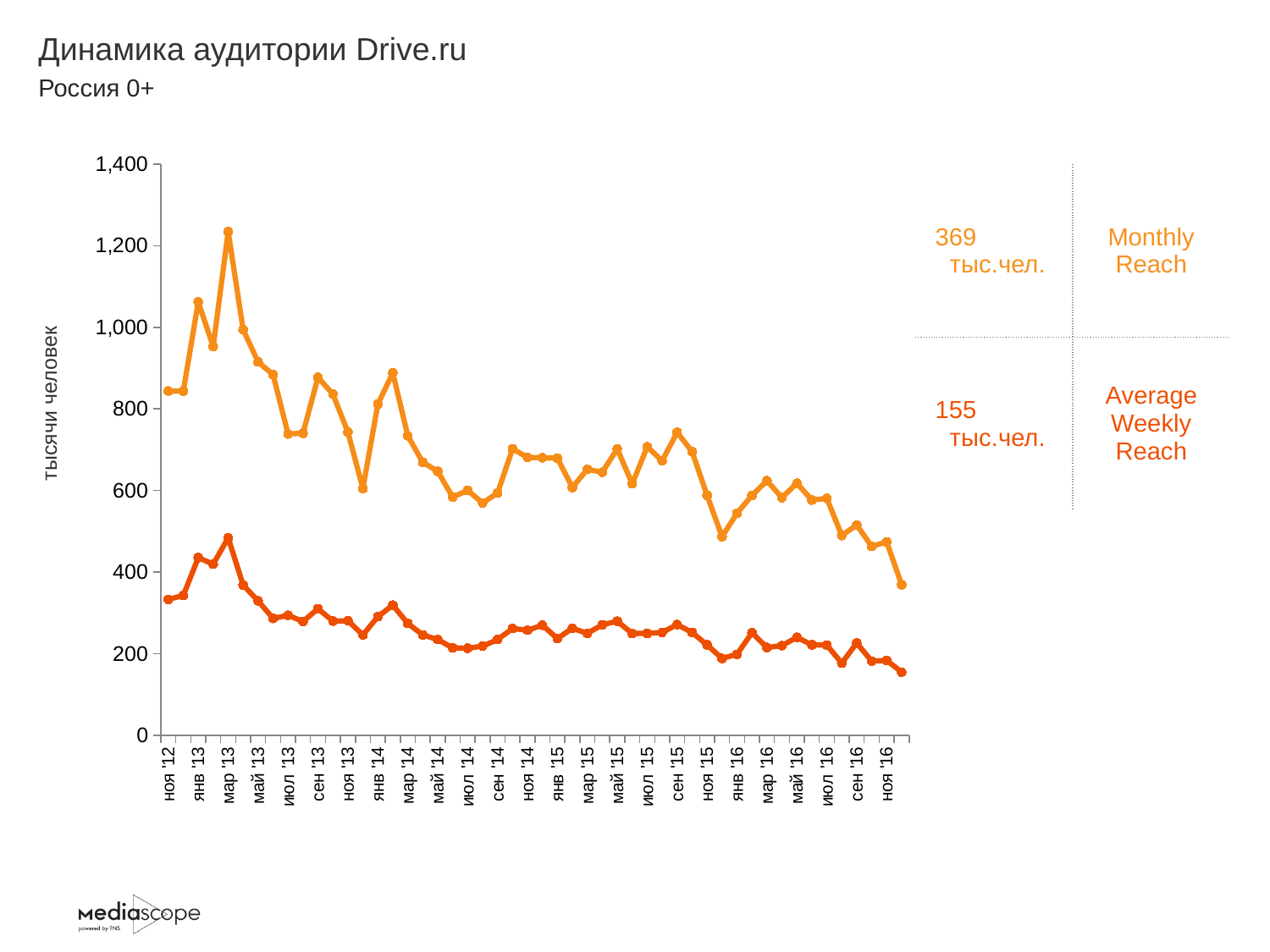
In which month does the Monthly Reach line reach its highest point? мар '13 What is the difference between the printed Monthly Reach (369 тыс.чел.) and Average Weekly Reach (155 тыс.чел.) values? 214 тыс.чел. Which series is higher at the end of the period, Monthly Reach or Average Weekly Reach? Monthly Reach What is the Average Weekly Reach value printed for the latest point (ноя '16)? 155 тыс.чел. What is the Monthly Reach value printed for the latest point (ноя '16)? 369 тыс.чел. Overall, do the Monthly Reach values rise or fall from ноя '12 to ноя '16? fall What kind of chart is shown on the slide? line chart What is the label on the vertical axis of the chart? тысячи человек How many data series are plotted on the chart? 2 Is the peak Average Weekly Reach value in мар '13 greater or less than 600? less Is the peak Monthly Reach value in мар '13 greater or less than 1,200? greater